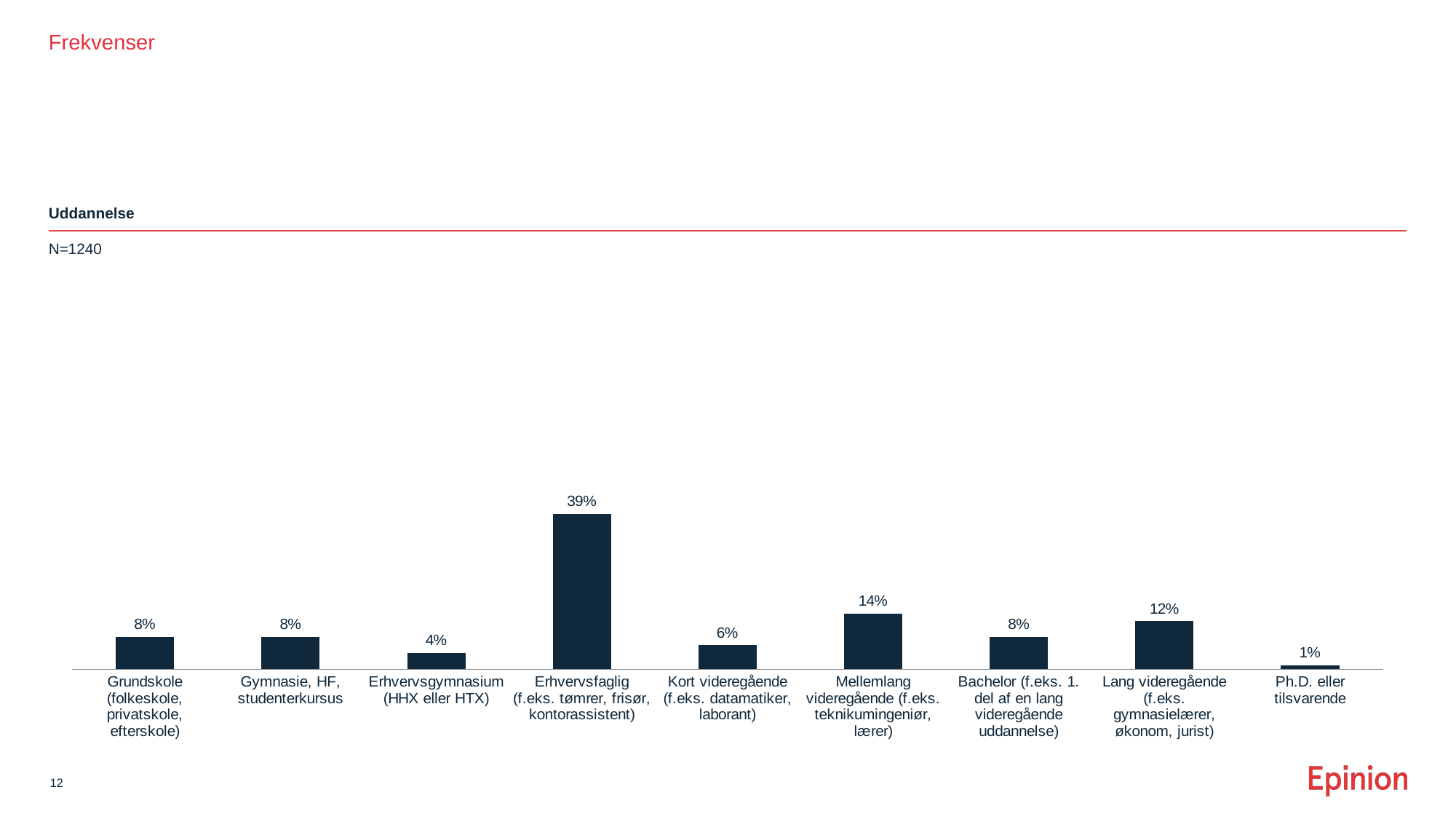
Which category has the highest value? Erhvervsfaglig (f.eks. tømrer, frisør, kontorassistent) What is the difference between the values for Lang videregående and Kort videregående? 6% What is the sample size (N) stated above the chart? N=1240 What is the difference between the values for Erhvervsfaglig and Mellemlang videregående? 25% How many categories are shown in the chart? 9 What kind of chart is shown on the slide? Bar chart What is the value for Erhvervsfaglig (f.eks. tømrer, frisør, kontorassistent)? 39% What is the value for Erhvervsgymnasium (HHX eller HTX)? 4% Which is larger, the value for Lang videregående or the value for Bachelor? Lang videregående Which category has the lowest value? Ph.D. eller tilsvarende What is the value for Ph.D. eller tilsvarende? 1% What is the value for Mellemlang videregående (f.eks. teknikumingeniør, lærer)? 14%